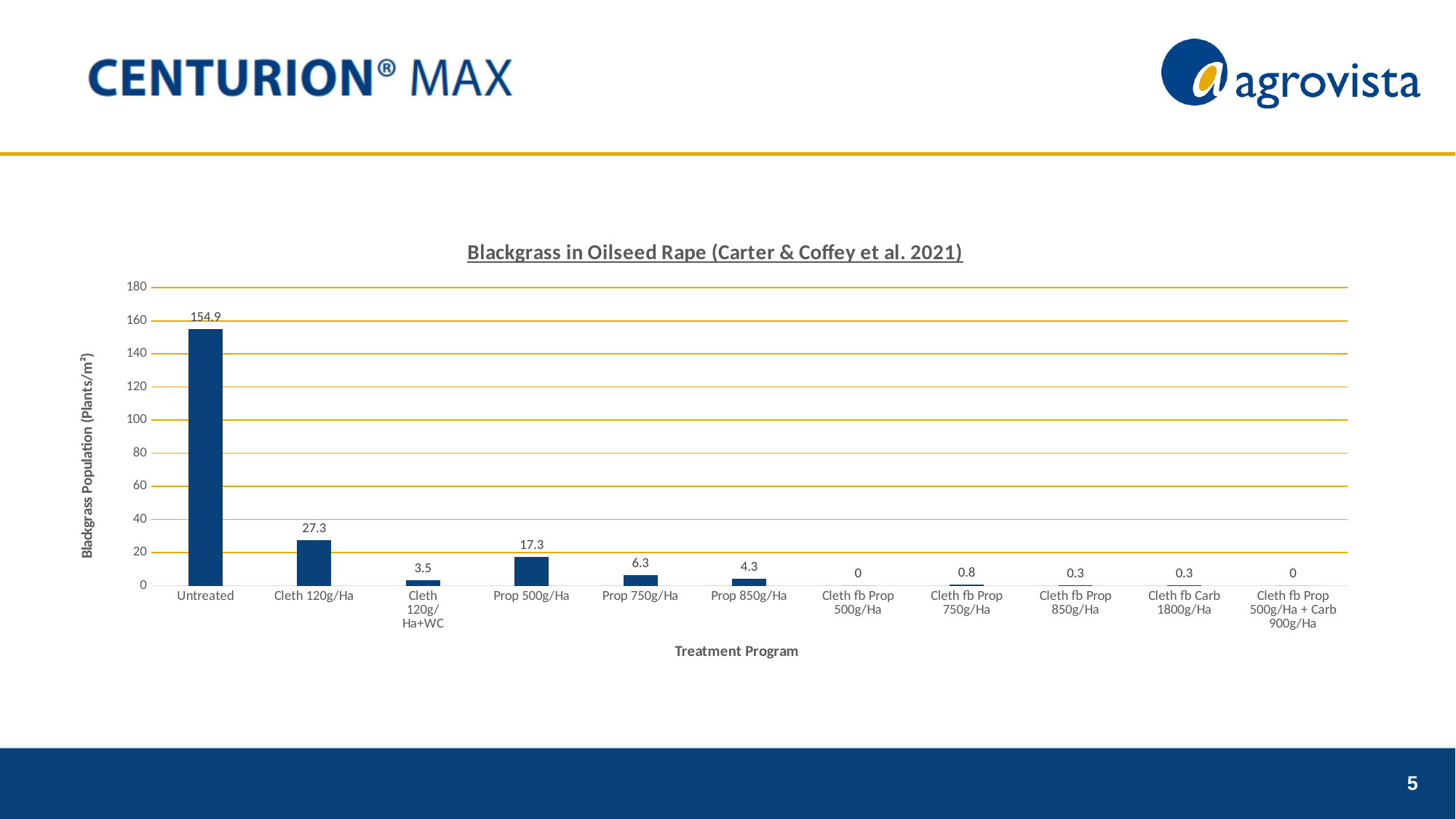
What is the blackgrass population for the Untreated treatment program? 154.9 Which has a larger value, Cleth 120g/Ha or Prop 500g/Ha? Cleth 120g/Ha What is the difference between the values for Prop 750g/Ha and Prop 850g/Ha? 2 How many treatment programs are shown on the x axis? 11 What kind of chart is shown on the slide? bar chart Is the value for Untreated greater or less than 140? greater Which treatment program has the highest blackgrass population? Untreated What is the value shown for Cleth fb Prop 750g/Ha? 0.8 What is the title of the chart? Blackgrass in Oilseed Rape (Carter & Coffey et al. 2021) What is the value shown for Prop 500g/Ha? 17.3 What is the difference between the values for Untreated and Cleth 120g/Ha? 127.6 What is the value shown for Cleth 120g/Ha? 27.3